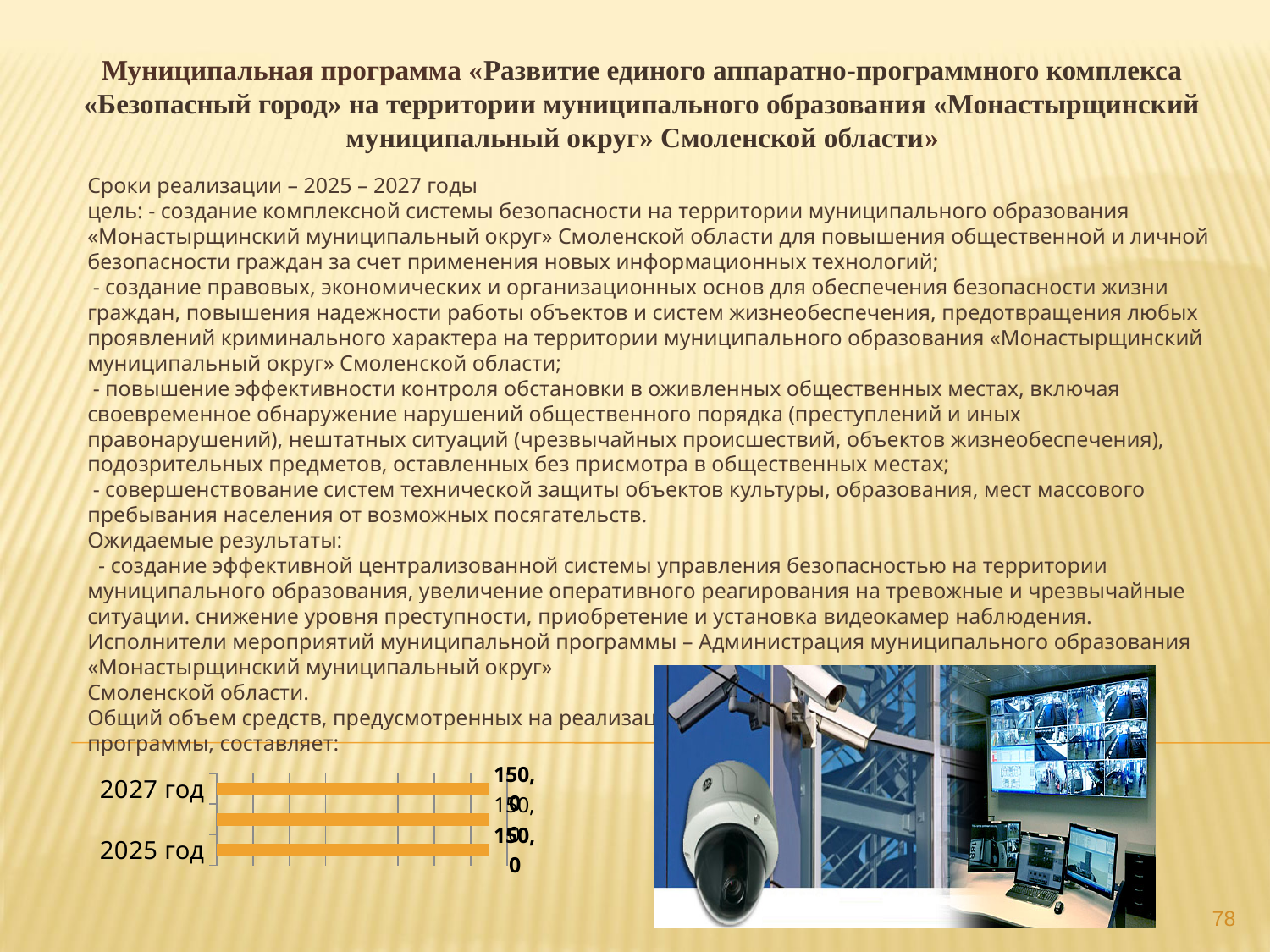
What is the difference between the values for 2027 год and 2025 год in the chart? 0,0 How many bars does the chart at the bottom left of the slide show? 3 What kind of chart is shown at the bottom left of the slide? bar chart What is the value shown for 2027 год in the chart? 150,0 Is the value for 2025 год in the chart larger than, smaller than, or equal to the value for 2027 год? equal What is the value shown for 2025 год in the chart? 150,0 Which category label appears at the top of the chart's vertical axis? 2027 год Do the values in the chart rise, fall, or stay the same from 2025 год to 2027 год? stay the same Which category label appears at the bottom of the chart's vertical axis? 2025 год